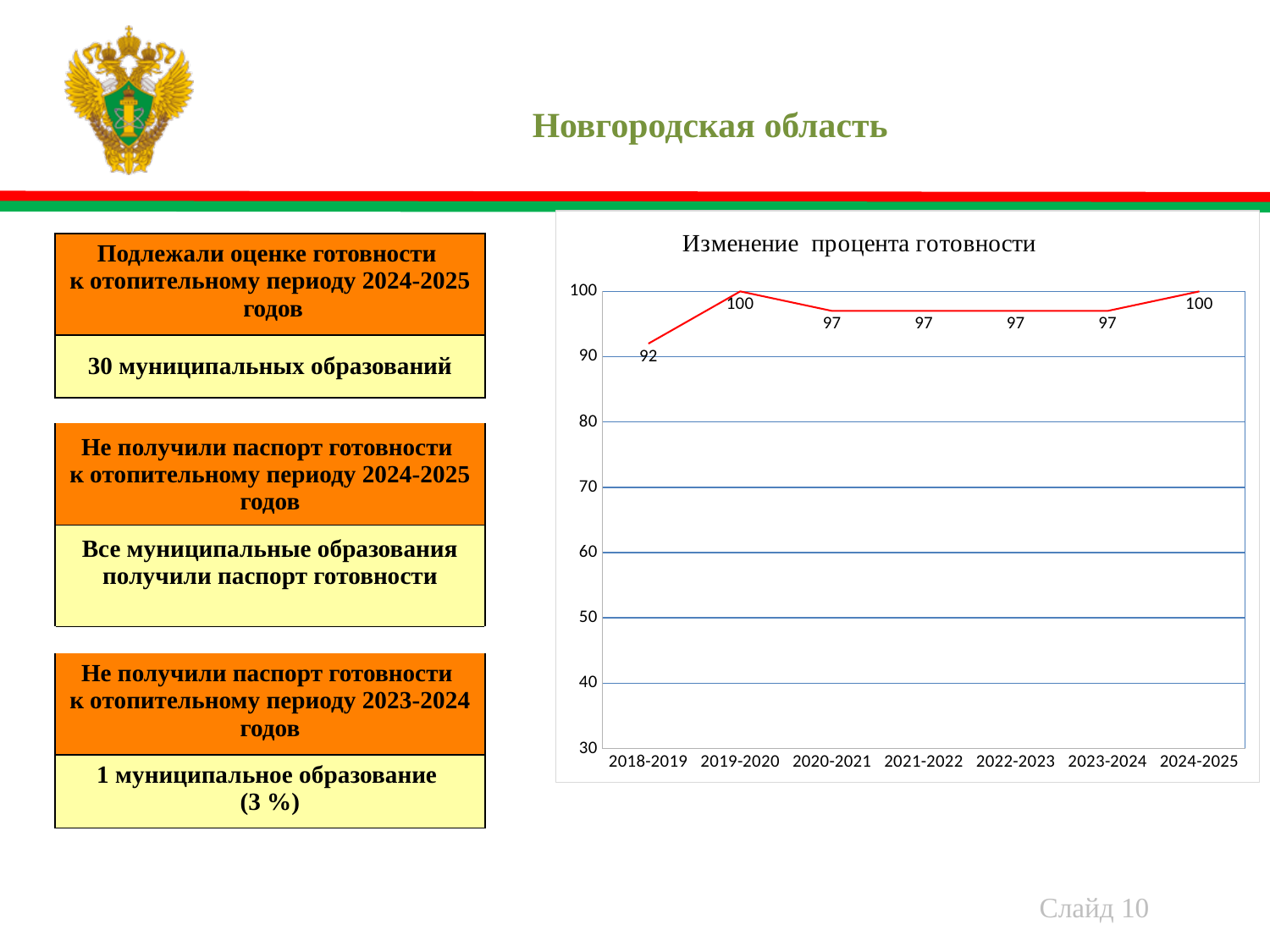
What is the value for 2018-2019? 92 Which is larger, the value for 2019-2020 or the value for 2020-2021? 2019-2020 What kind of chart is this? line chart What is the title of the chart? Изменение процента готовности Does the value rise or fall from 2018-2019 to 2019-2020? rise Is the value for 2018-2019 greater or less than 90? greater Which period has the lowest value? 2018-2019 What is the difference between the values for 2024-2025 and 2023-2024? 3 What is the value for 2024-2025? 100 How many periods are shown on the x axis? 7 What is the difference between the values for 2019-2020 and 2018-2019? 8 What is the value for 2021-2022? 97